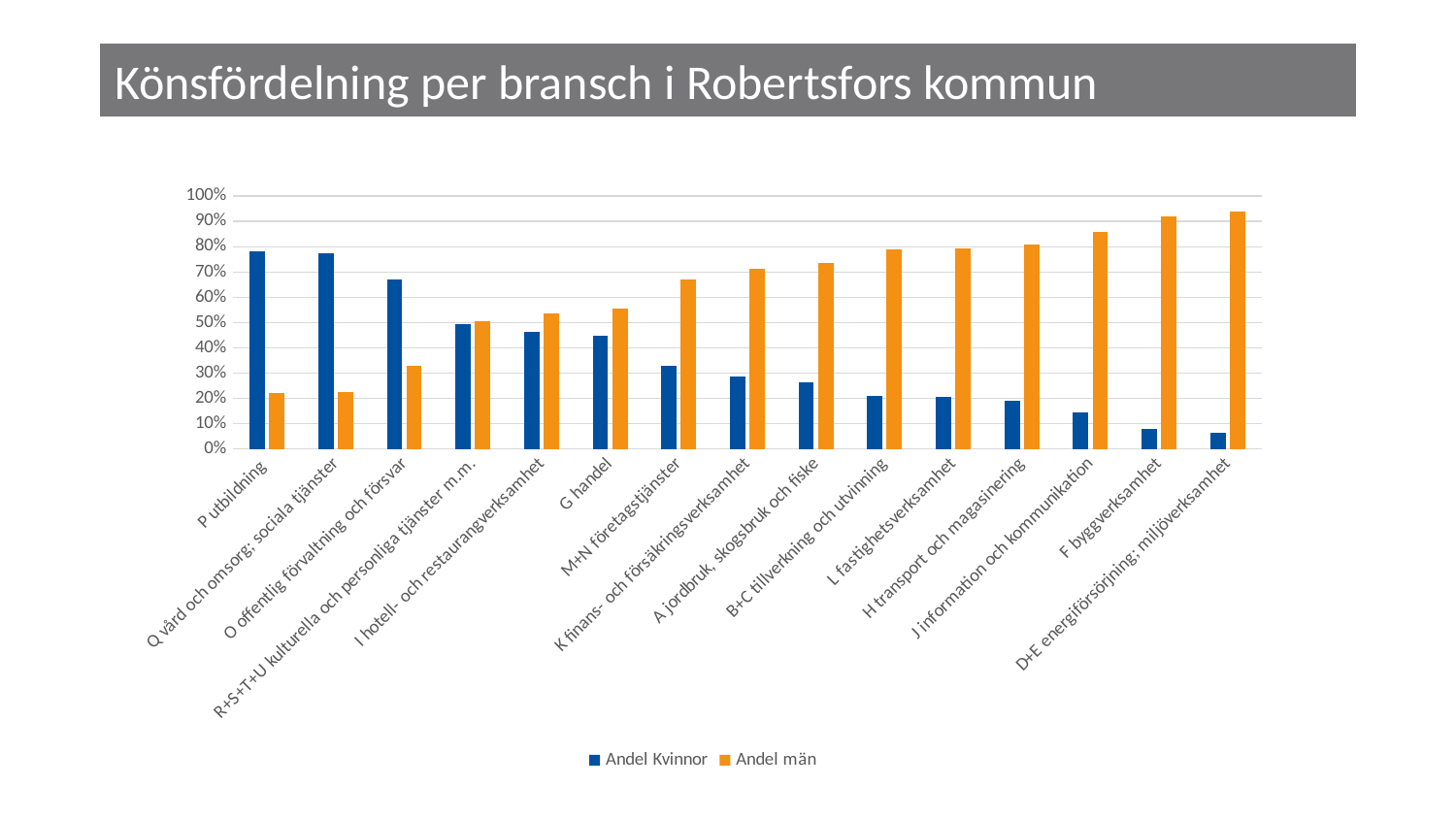
Do the Andel män values generally rise or fall from left to right along the x axis? rise How many series does the legend list? 2 Is the Andel Kvinnor value for P utbildning greater or less than 70%? greater Which category has the highest value for Andel män? D+E energiförsörjning; miljöverksamhet Is the Andel Kvinnor value for J information och kommunikation greater or less than 20%? less For O offentlig förvaltning och försvar, which is larger: Andel Kvinnor or Andel män? Andel Kvinnor Is the Andel män value for F byggverksamhet greater or less than 80%? greater Which category has the lowest value for Andel Kvinnor? D+E energiförsörjning; miljöverksamhet How many industry categories are shown on the x axis? 15 What kind of chart is shown on the slide? bar chart For I hotell- och restaurangverksamhet, which is larger: Andel Kvinnor or Andel män? Andel män